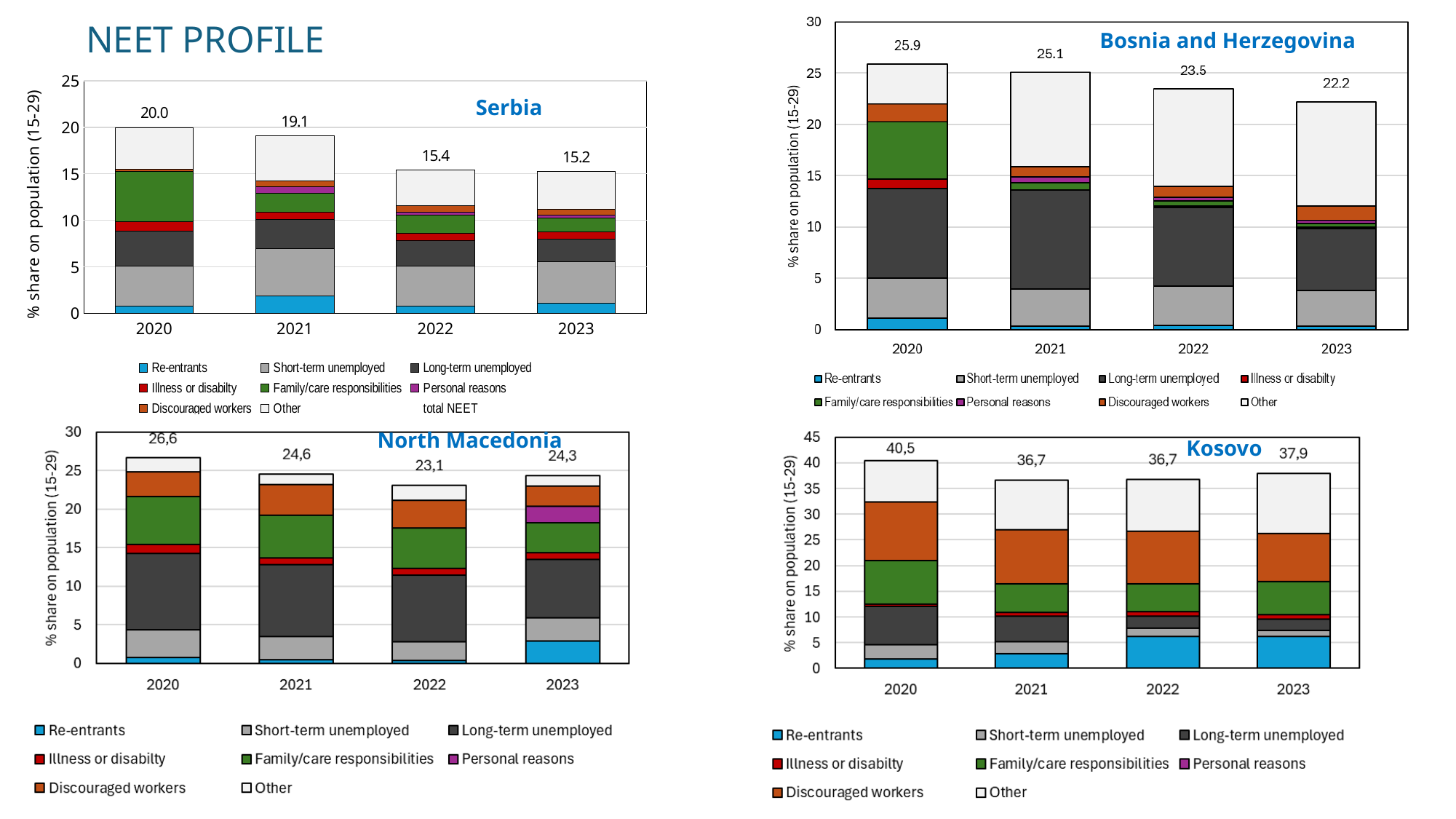
In the Bosnia and Herzegovina chart, what is the total value labelled for 2023? 22.2 In the Kosovo chart, which year has the highest total NEET value? 2020 In the Serbia chart, what is the total NEET value labelled for 2020? 20.0 In the North Macedonia chart, which year has the larger total, 2022 or 2023? 2023 In the Serbia chart, which year has the lowest total NEET value? 2023 In the Serbia chart, do the total NEET values rise or fall from 2020 to 2023? fall What kind of chart is the Bosnia and Herzegovina chart? stacked bar chart In the Kosovo chart, what is the total value labelled for 2020? 40,5 How many years are shown on the x axis of the Kosovo chart? 4 How many series does the legend of the Kosovo chart list? 8 In the North Macedonia chart, what is the total value labelled for 2021? 24,6 In the Bosnia and Herzegovina chart, what is the difference between the 2020 total and the 2023 total? 3.7